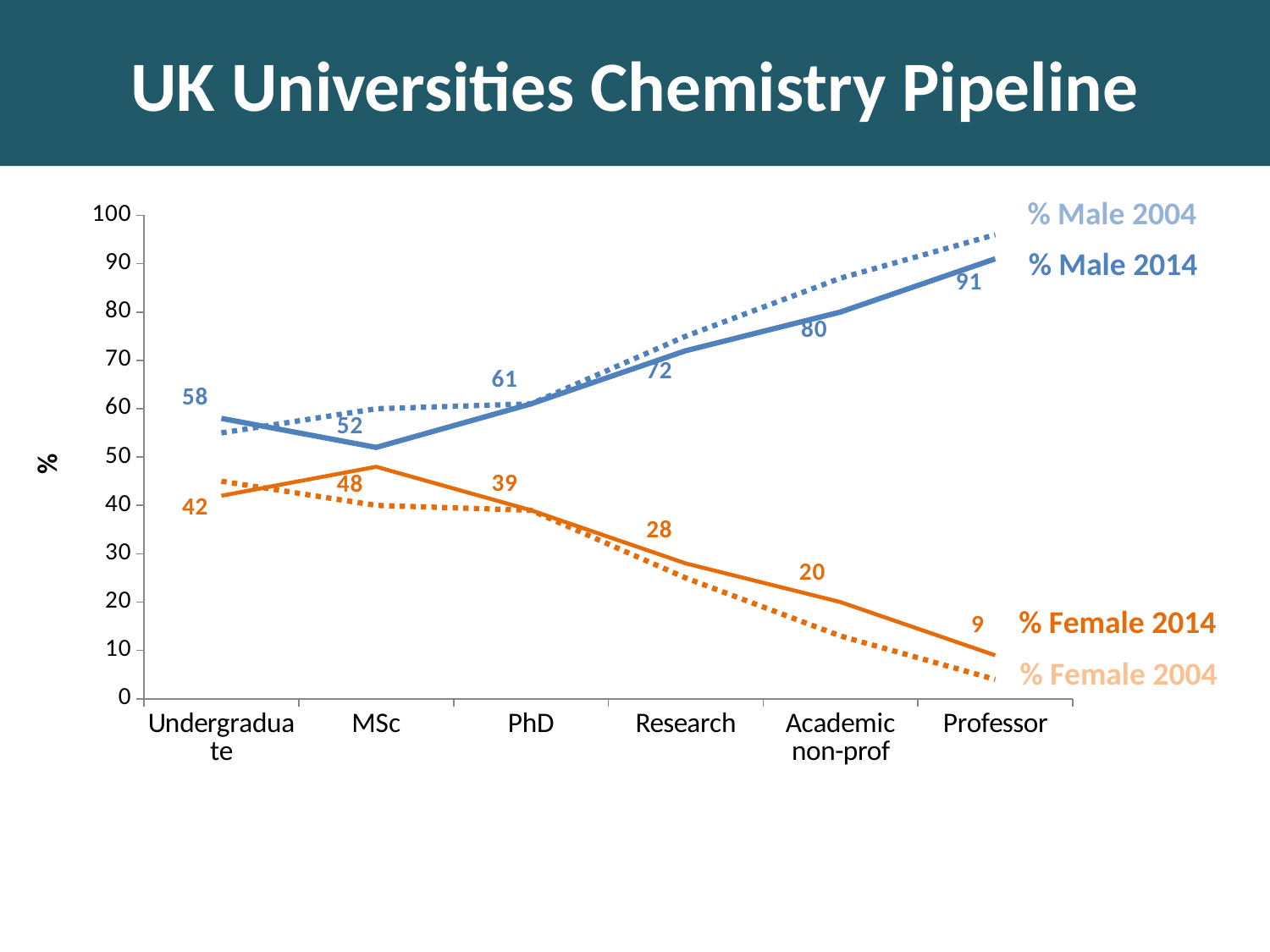
At which career stage is the % Female 2014 value lowest? Professor What is the % Female 2014 value for MSc? 48 How many series are plotted on the chart? 4 At which career stage is the % Male 2014 value highest? Professor Does the % Female 2014 line rise or fall from PhD to Professor? fall Is the % Male 2004 value for Professor greater or less than 90? greater What type of chart is shown on the slide? line chart What is the difference between the % Male 2014 and % Female 2014 values at PhD? 22 What is the % Male 2014 value for Professor? 91 How many career stages are shown on the x axis? 6 Which is larger at MSc: the % Male 2014 value or the % Female 2014 value? % Male 2014 What is the % Female 2014 value for Academic non-prof? 20